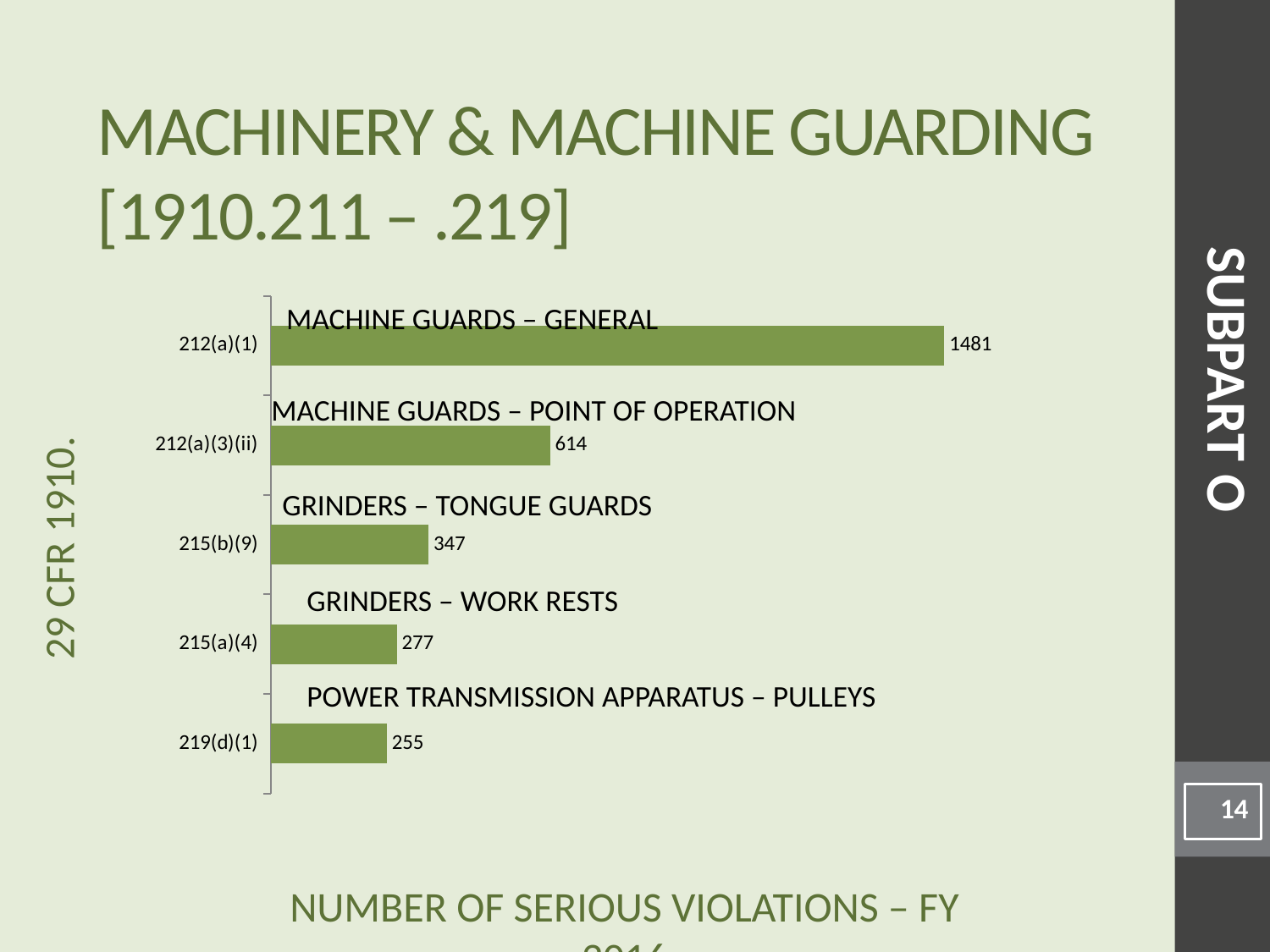
What is the difference between the values for 215(a)(4) and 219(d)(1)? 22 What is the difference between the values for 212(a)(1) and 212(a)(3)(ii)? 867 What is the value shown for 215(b)(9)? 347 What kind of chart is shown on the slide? Bar chart What is the number of serious violations for 212(a)(1)? 1481 Which category has the lowest number of serious violations? 219(d)(1) Which category has the highest number of serious violations? 212(a)(1) What is the value shown for 219(d)(1)? 255 How many categories are plotted in the chart? 5 What is the number of serious violations for 212(a)(3)(ii)? 614 Which standard is labelled 'GRINDERS – WORK RESTS' in the chart? 215(a)(4) Which has a larger value, 215(b)(9) or 215(a)(4)? 215(b)(9)